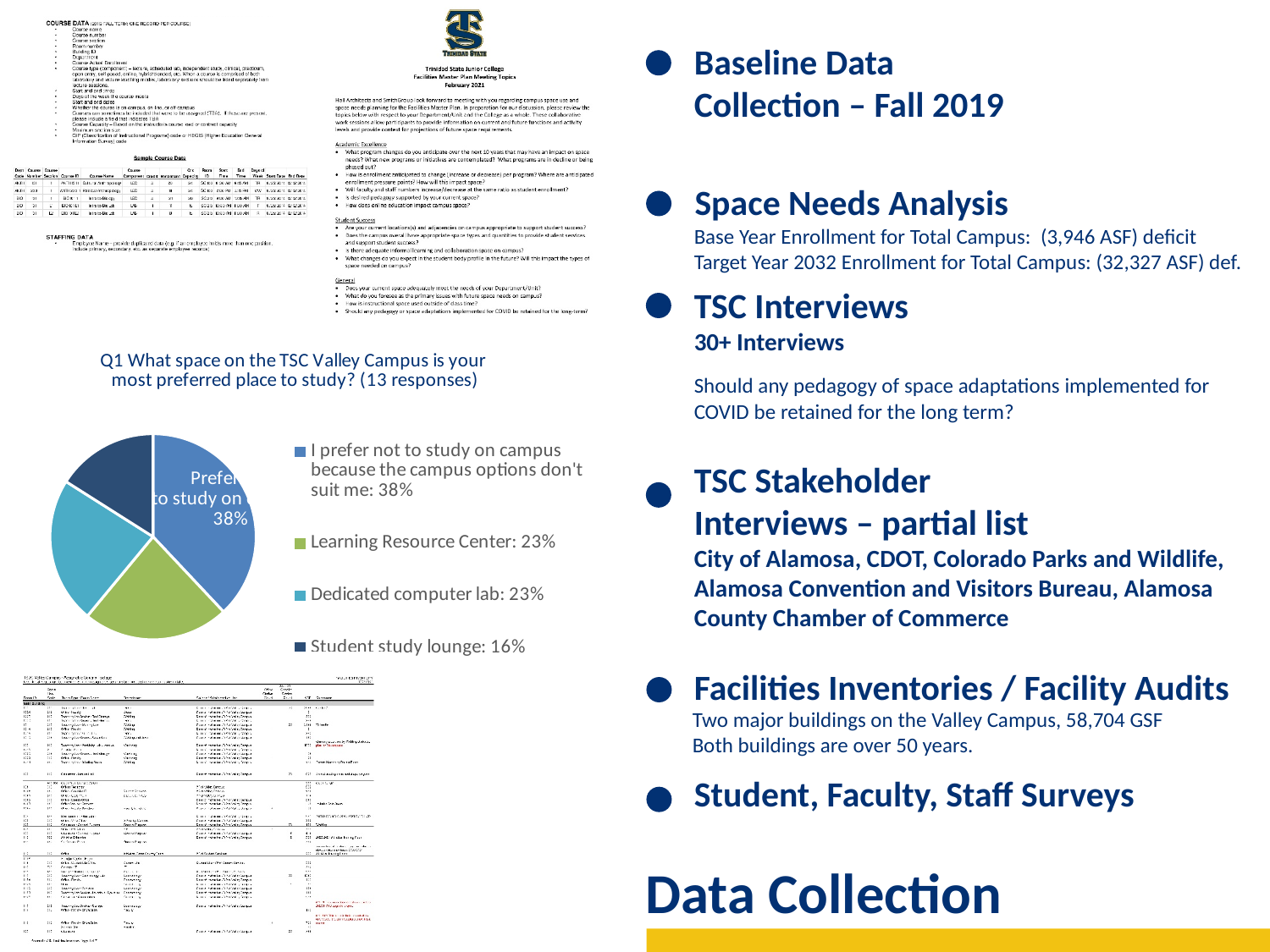
Which category has the largest share of the pie? I prefer not to study on campus because the campus options don't suit me What share of the pie is 'Student study lounge'? 16% What share of the pie is 'Learning Resource Center'? 23% What share of the pie is 'I prefer not to study on campus because the campus options don't suit me'? 38% Which is larger: the share for 'Dedicated computer lab' or the share for 'Student study lounge'? Dedicated computer lab How many slices does the pie chart have? 4 How many responses does the pie chart title say were collected? 13 What is the difference in percentage points between 'Learning Resource Center' and 'Student study lounge'? 7 What kind of chart is shown on the slide? pie chart Which category has the smallest share of the pie? Student study lounge What is the title of the pie chart? Q1 What space on the TSC Valley Campus is your most preferred place to study? (13 responses)